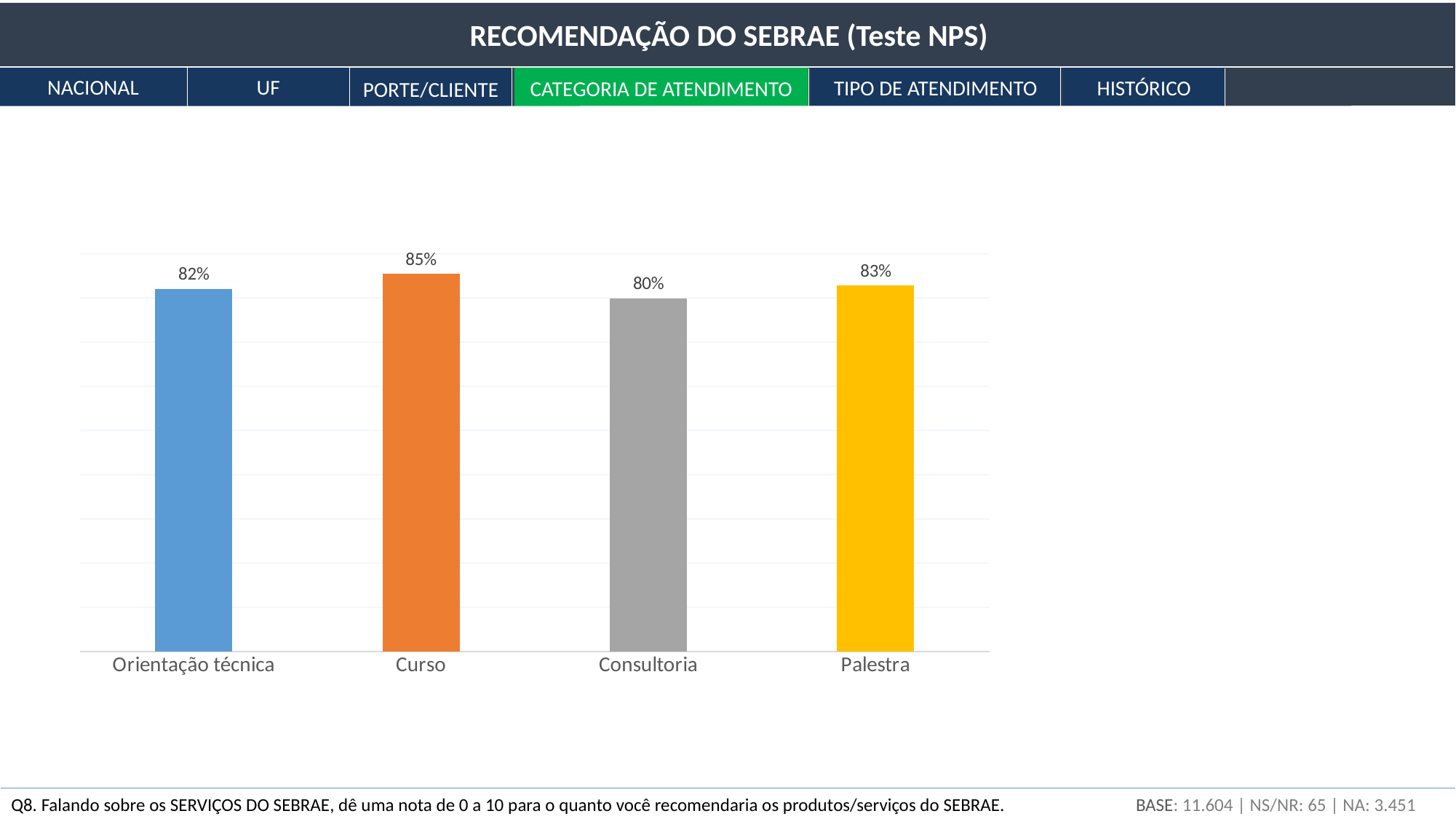
What kind of chart is shown on the slide? Bar chart Which category has the highest value? Curso What is the value for Curso? 85% What colour is the bar for Consultoria? Grey How many categories are shown in the chart? 4 What is the difference between the values for Curso and Consultoria? 5% Which is larger, the value for Curso or the value for Palestra? Curso What is the value for Palestra? 83% What is the value for Orientação técnica? 82% What is the difference between the values for Palestra and Orientação técnica? 1% Which category has the lowest value? Consultoria What is the value for Consultoria? 80%